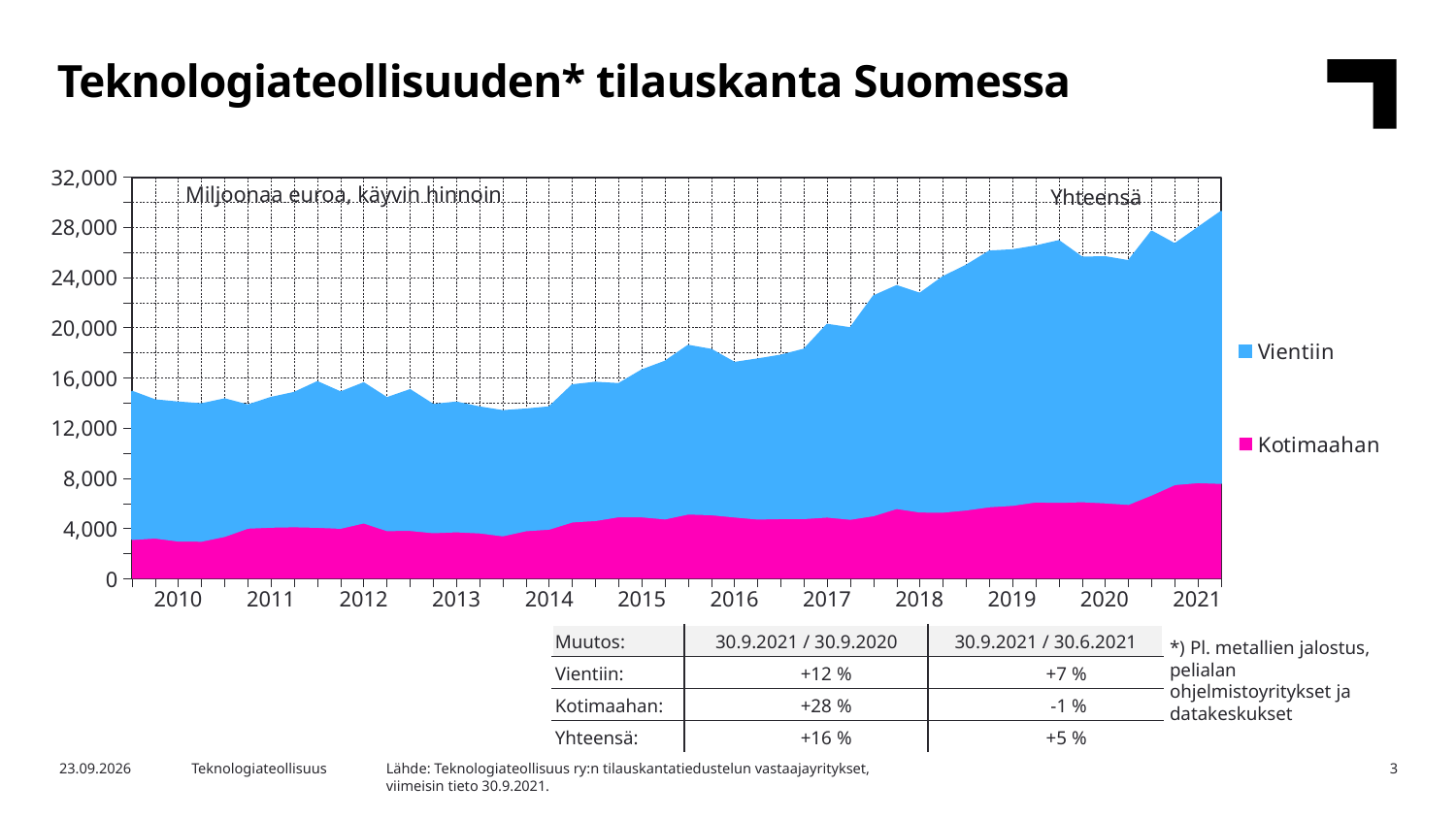
What is the title of the chart? Teknologiateollisuuden* tilauskanta Suomessa Which series is larger at the end of 2021, Vientiin or Kotimaahan? Vientiin Is the Kotimaahan value at the end of 2021 greater or less than 4,000? greater What type of chart is shown on the slide? Stacked area chart Is the total (Yhteensä) value at the end of 2021 greater or less than 24,000? greater How many years are labelled on the x axis? 12 Is the Kotimaahan value at the start of 2010 greater or less than 4,000? less How many series does the legend list? 2 What are the two series named in the legend? Vientiin and Kotimaahan Does the total order backlog (Yhteensä) rise or fall overall from 2010 to 2021? rise